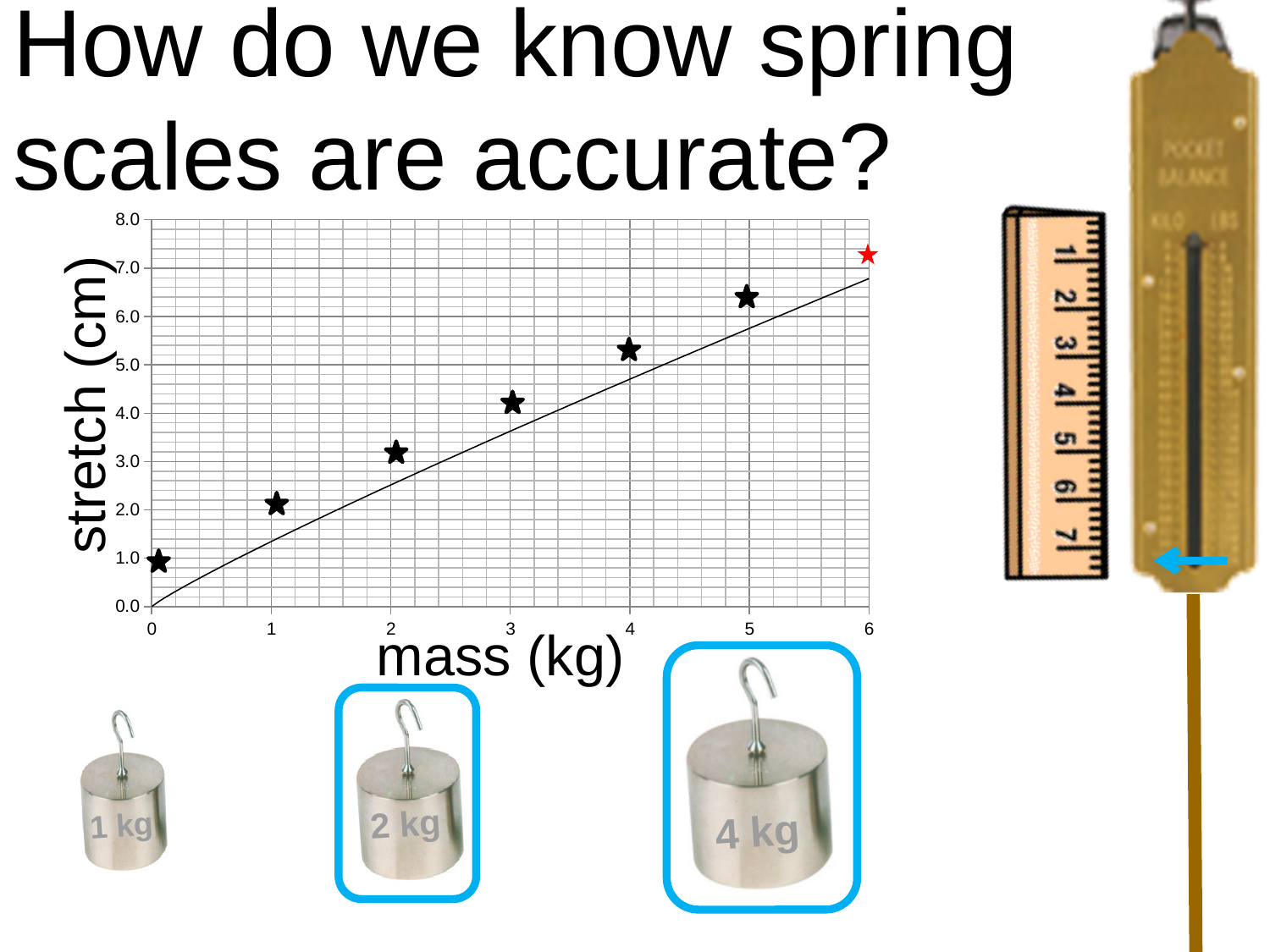
What is the title of the y axis of the chart? stretch (cm) How many data points (stars) are plotted on the chart? 7 Is the stretch value at a mass of 3 kg greater or less than 5.0? less At which mass is the plotted stretch the lowest? 0 kg What is the title of the x axis of the chart? mass (kg) At which mass is the plotted stretch the highest? 6 kg What kind of chart is shown on the slide? scatter chart Is the stretch value at a mass of 6 kg (the red star) greater or less than 7.0? greater Is the stretch value at a mass of 2 kg greater or less than 4.0? less Do the stretch values rise or fall as mass increases along the x axis? rise